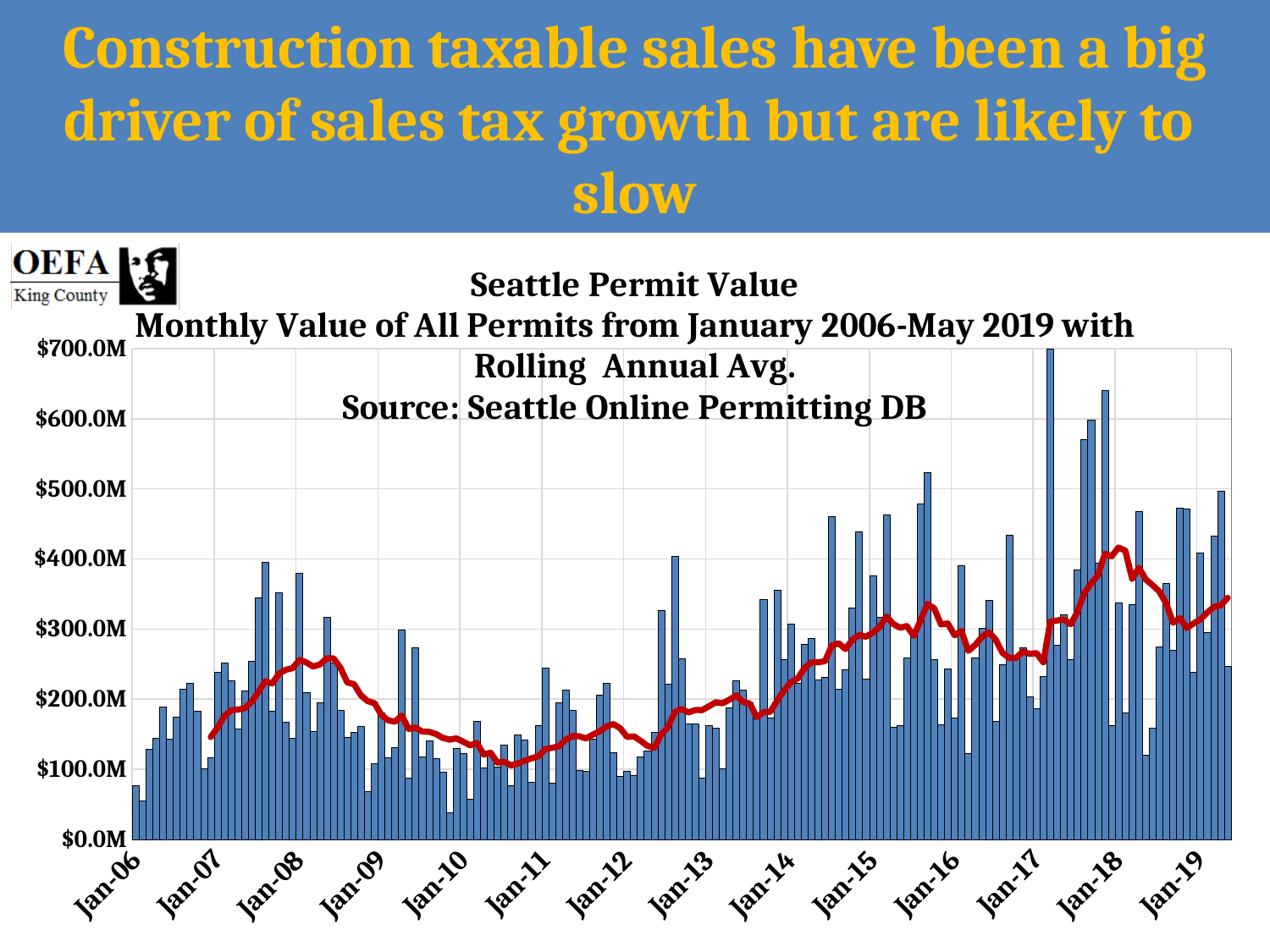
How many January labels are shown along the horizontal axis? 14 Does the rolling annual average rise or fall between Jan-09 and Jan-10? fall Is the tallest monthly bar (in 2017) greater or less than $600.0M? greater What is the highest value shown on the vertical axis? $700.0M What is the lowest value shown on the vertical axis? $0.0M What kind of chart is shown on the slide? A bar chart with a line overlay According to the chart subtitle, what is the source of the data? Seattle Online Permitting DB What is the title of the chart? Seattle Permit Value Is the rolling annual average (red line) at Jan-10 greater or less than $200.0M? less Is the rolling annual average (red line) at Jan-18 greater or less than $300.0M? greater Which is larger, the rolling annual average at Jan-18 or at Jan-10? Jan-18